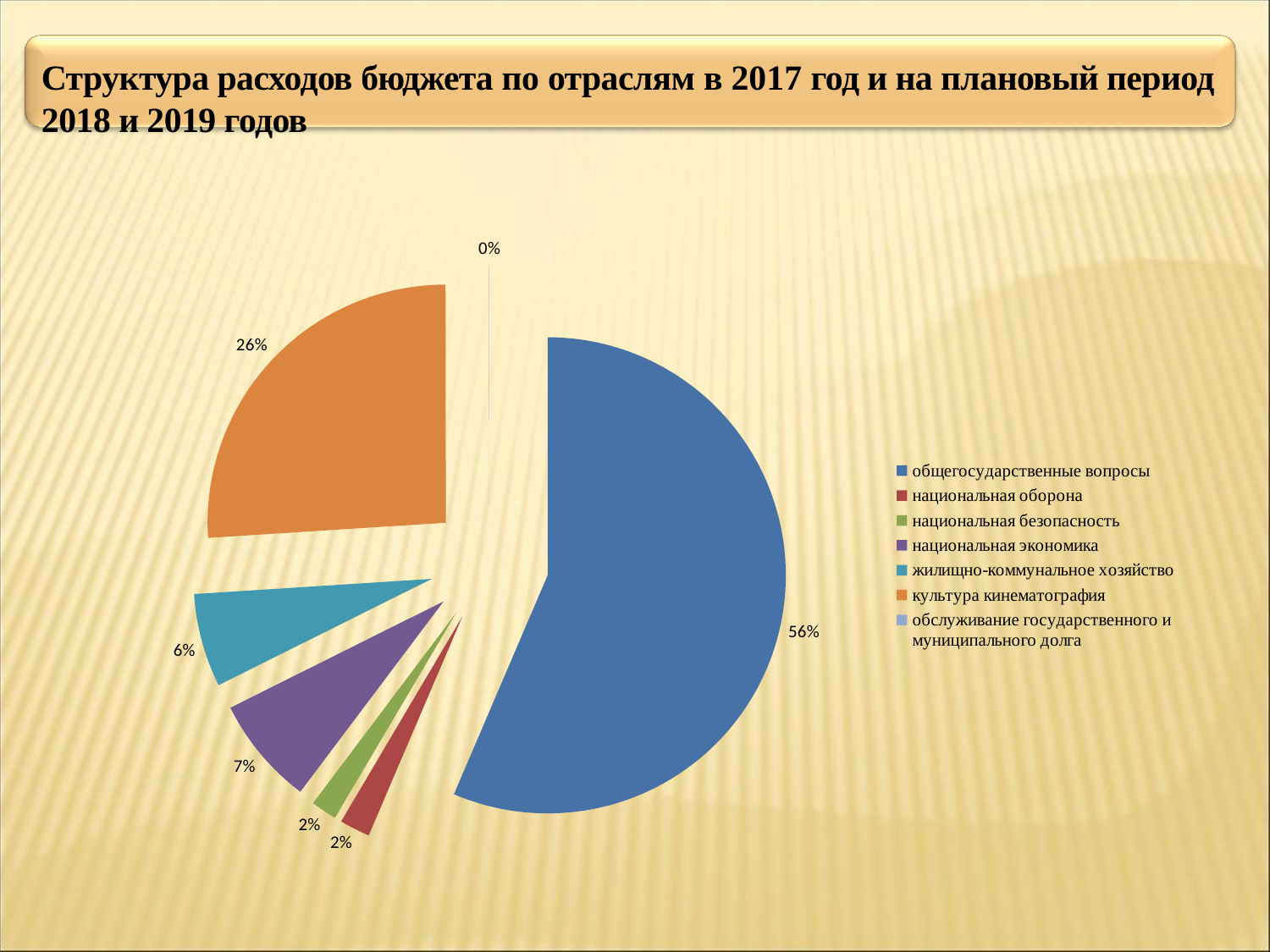
Which is larger, the share for национальная экономика or the share for жилищно-коммунальное хозяйство? национальная экономика What share of the pie does общегосударственные вопросы have? 56% What is the difference in percentage points between общегосударственные вопросы and культура кинематография? 30 What colour is the slice for культура кинематография? orange What share of the pie does обслуживание государственного и муниципального долга have? 0% What share of the pie does жилищно-коммунальное хозяйство have? 6% Which category has the smallest slice of the pie? обслуживание государственного и муниципального долга What kind of chart is shown on the slide? pie chart Which category has the largest slice of the pie? общегосударственные вопросы How many categories does the legend list? 7